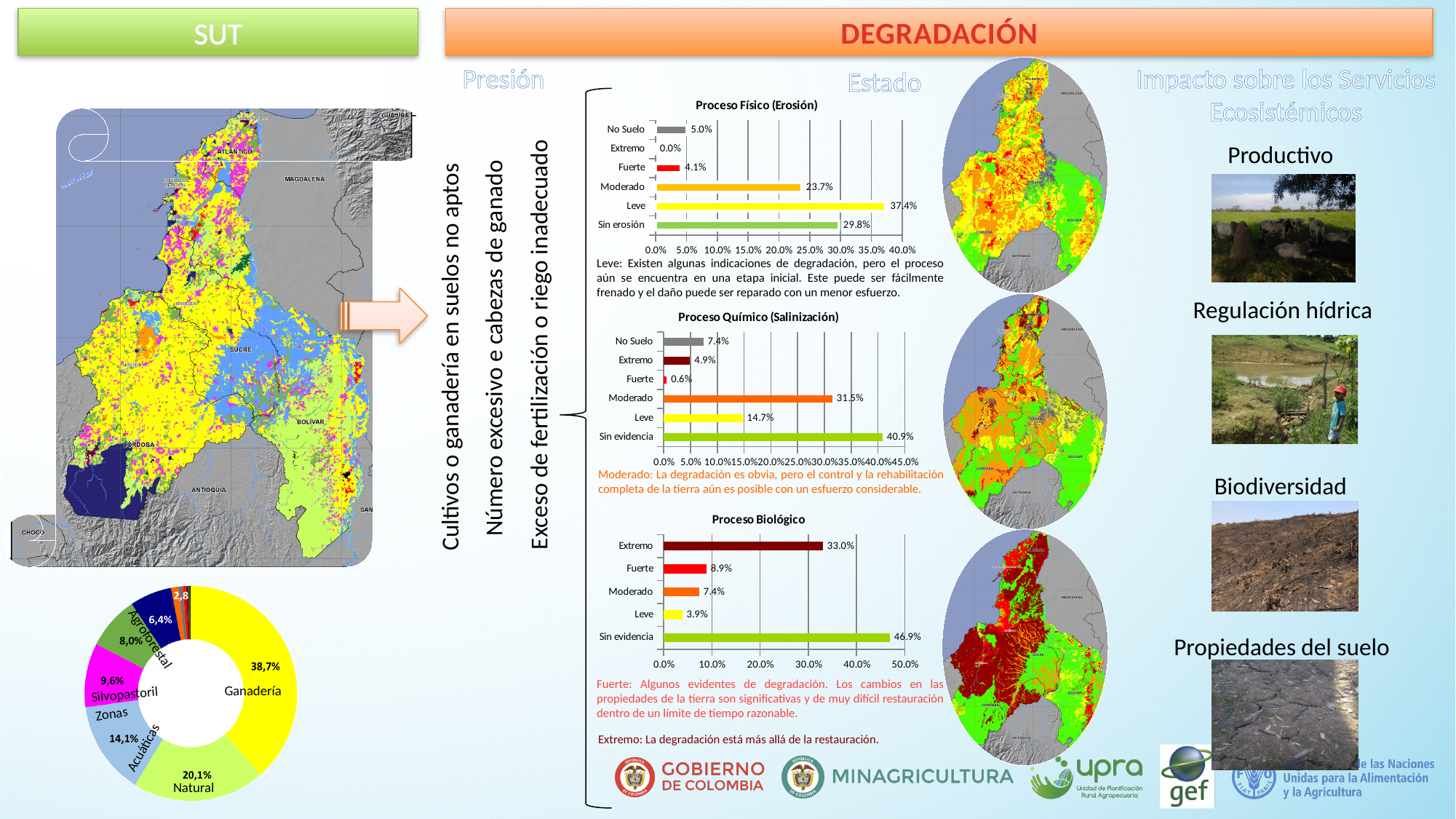
In the 'Proceso Físico (Erosión)' chart, which category has the highest value? Leve In the 'Proceso Químico (Salinización)' chart, which is larger, Leve or Moderado? Moderado What kind of chart is the 'Proceso Biológico' chart? Bar chart In the 'Proceso Físico (Erosión)' chart, what is the value for Leve? 37.4% In the 'Proceso Químico (Salinización)' chart, which category has the lowest value? Fuerte In the 'Proceso Físico (Erosión)' chart, what is the difference between Leve and Moderado? 13.7% In the 'Proceso Biológico' chart, how many categories are shown? 5 In the donut chart at the bottom left, what share does Ganadería have? 38,7% In the 'Proceso Químico (Salinización)' chart, what is the value for Moderado? 31.5% In the 'Proceso Biológico' chart, what is the value for Extremo? 33.0% In the 'Proceso Biológico' chart, what is the difference between Sin evidencia and Extremo? 13.9% In the 'Proceso Físico (Erosión)' chart, which category has the lowest value? Extremo